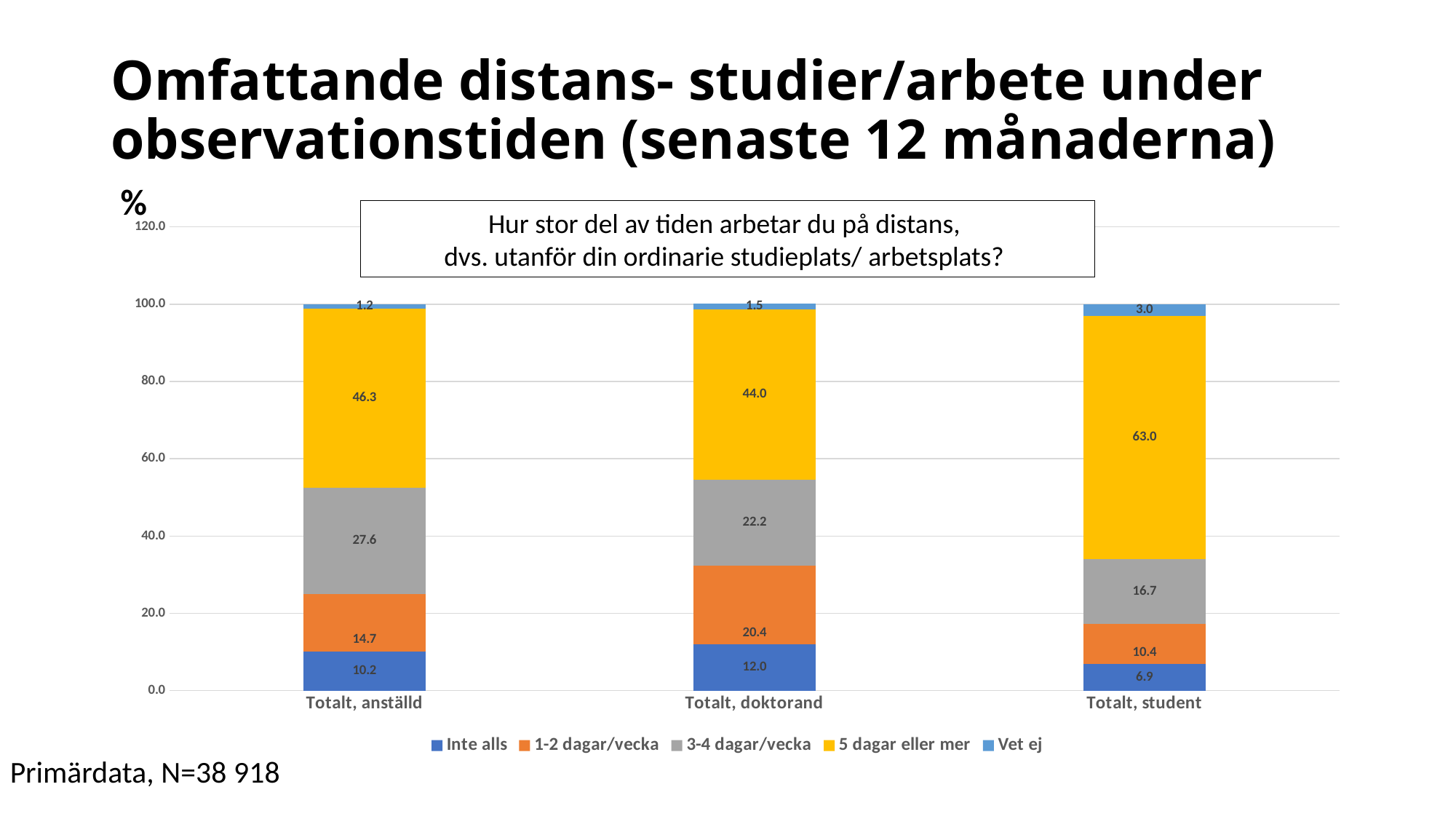
What kind of chart is shown on the slide? Stacked bar chart Which category has the lowest value for 'Inte alls'? Totalt, student Which category has the highest value for '5 dagar eller mer'? Totalt, student What is the value for '3-4 dagar/vecka' in the 'Totalt, anställd' bar? 27.6 What is the total of the 'Totalt, anställd' stacked bar? 100.0 What is the value for 'Inte alls' in the 'Totalt, doktorand' bar? 12.0 Which series is shown in yellow in the legend? 5 dagar eller mer What is the difference between the '1-2 dagar/vecka' values for 'Totalt, doktorand' and 'Totalt, student'? 10.0 How many categories are shown on the x axis? 3 How many series does the legend list? 5 What is the value for '5 dagar eller mer' in the 'Totalt, student' bar? 63.0 Which is larger: the 'Vet ej' value for 'Totalt, student' or for 'Totalt, anställd'? Totalt, student